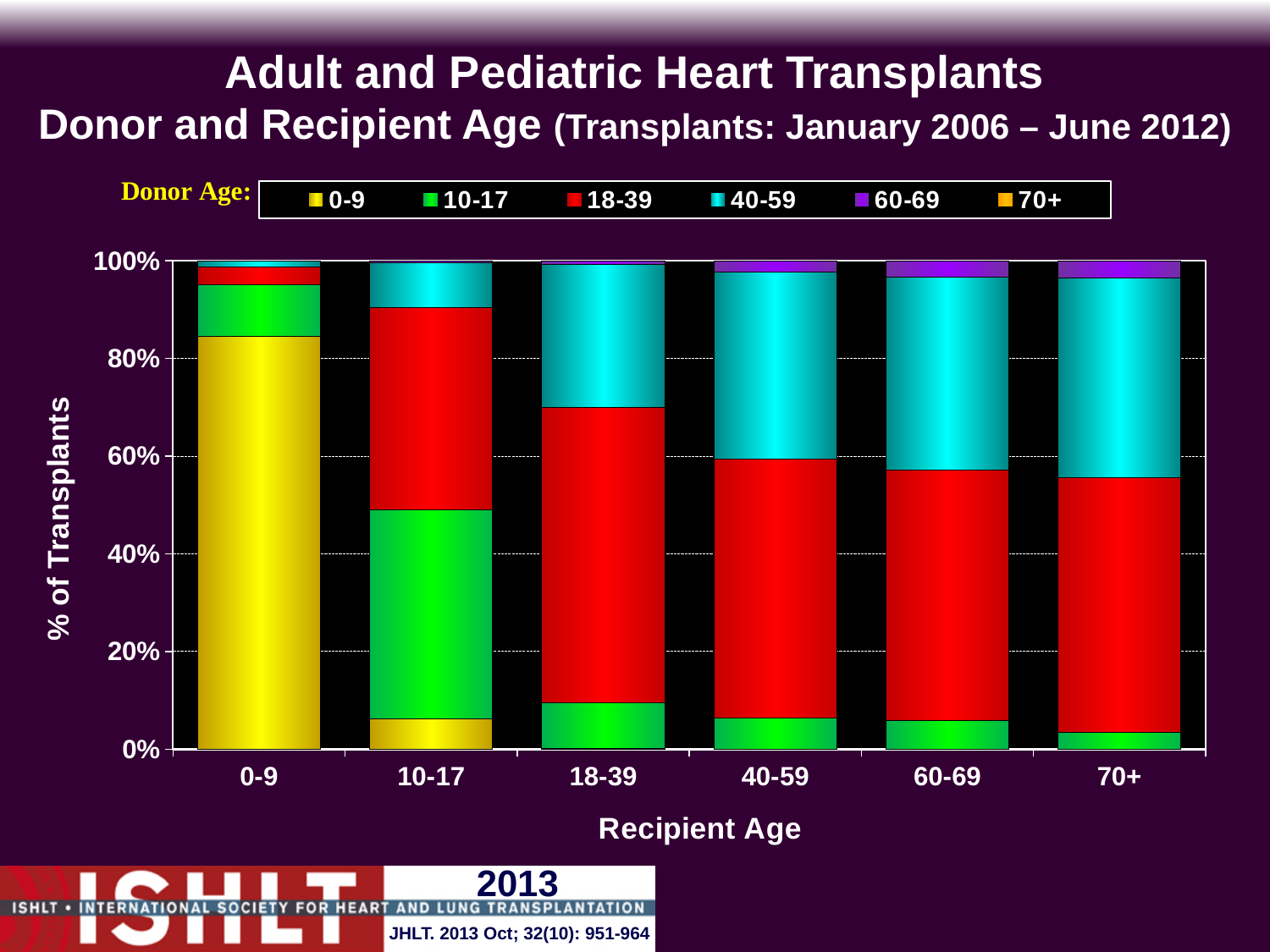
Which recipient age group has the largest share of transplants from donors aged 10-17? 10-17 How many donor age groups does the legend list? 6 Which recipient age group has the largest share of transplants from donors aged 0-9? 0-9 What kind of chart is shown on the slide? Stacked bar chart Is the share of transplants from donors aged 0-9 for recipients aged 0-9 greater or less than 80%? greater How many recipient age categories are shown on the x axis? 6 Which recipient age group has the largest share of transplants from donors aged 18-39? 18-39 Is the share of transplants from donors aged 0-9 for recipients aged 10-17 greater or less than 20%? less Does the share of transplants from donors aged 40-59 generally rise or fall as recipient age increases from 0-9 to 70+? rise Is the share of transplants from donors aged 18-39 for recipients aged 18-39 greater or less than 40%? greater What is the title of the x axis? Recipient Age Which recipient age group has a larger share of transplants from donors aged 40-59: 0-9 or 70+? 70+